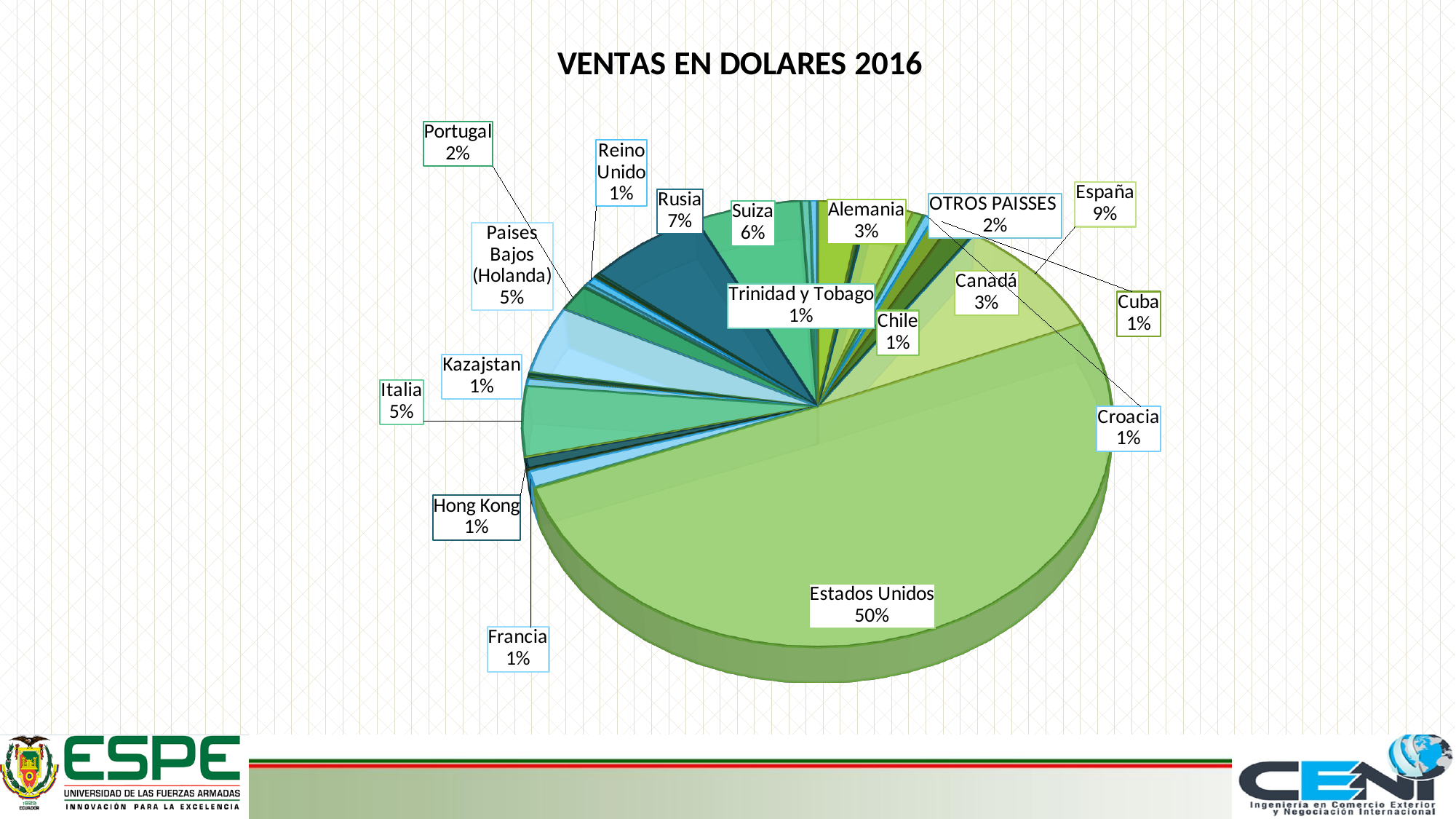
What percentage is shown for Rusia? 7% Which is larger, the share for Suiza or the share for Alemania? Suiza What share of the pie does Estados Unidos have? 50% What is the title of the chart? VENTAS EN DOLARES 2016 What is the difference in percentage points between Estados Unidos and Italia? 45% What is the difference in percentage points between España and Rusia? 2% How many slices (categories) are labelled in the pie chart? 18 What percentage is shown for Canadá? 3% What type of chart is shown on the slide? pie chart What percentage is shown for Paises Bajos (Holanda)? 5% Which country has the largest slice of the pie? Estados Unidos What percentage is shown for España? 9%